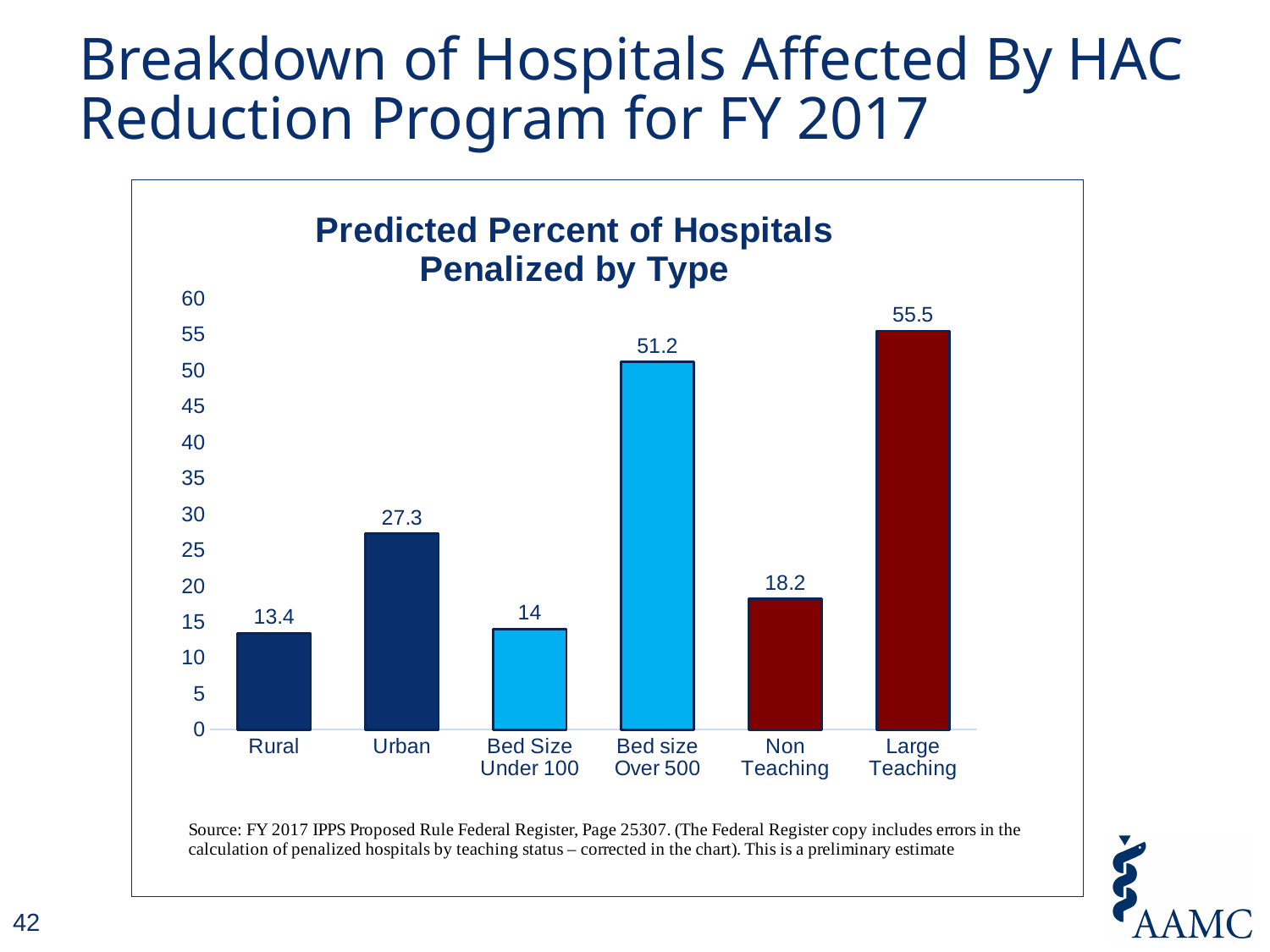
What is the value shown for Urban hospitals? 27.3 What is the title of the chart? Predicted Percent of Hospitals Penalized by Type Which is larger, the value for Urban or the value for Non Teaching? Urban Which hospital type has the highest predicted percent penalized? Large Teaching What kind of chart is shown on the slide? Bar chart What is the difference between the values for Bed size Over 500 and Bed Size Under 100? 37.2 Which hospital type has the lowest predicted percent penalized? Rural What is the value shown for Non Teaching hospitals? 18.2 What is the value shown for Bed Size Under 100? 14 How many hospital types are shown on the chart? 6 What is the predicted percent of hospitals penalized for Rural hospitals? 13.4 What is the difference between the values for Large Teaching and Non Teaching hospitals? 37.3